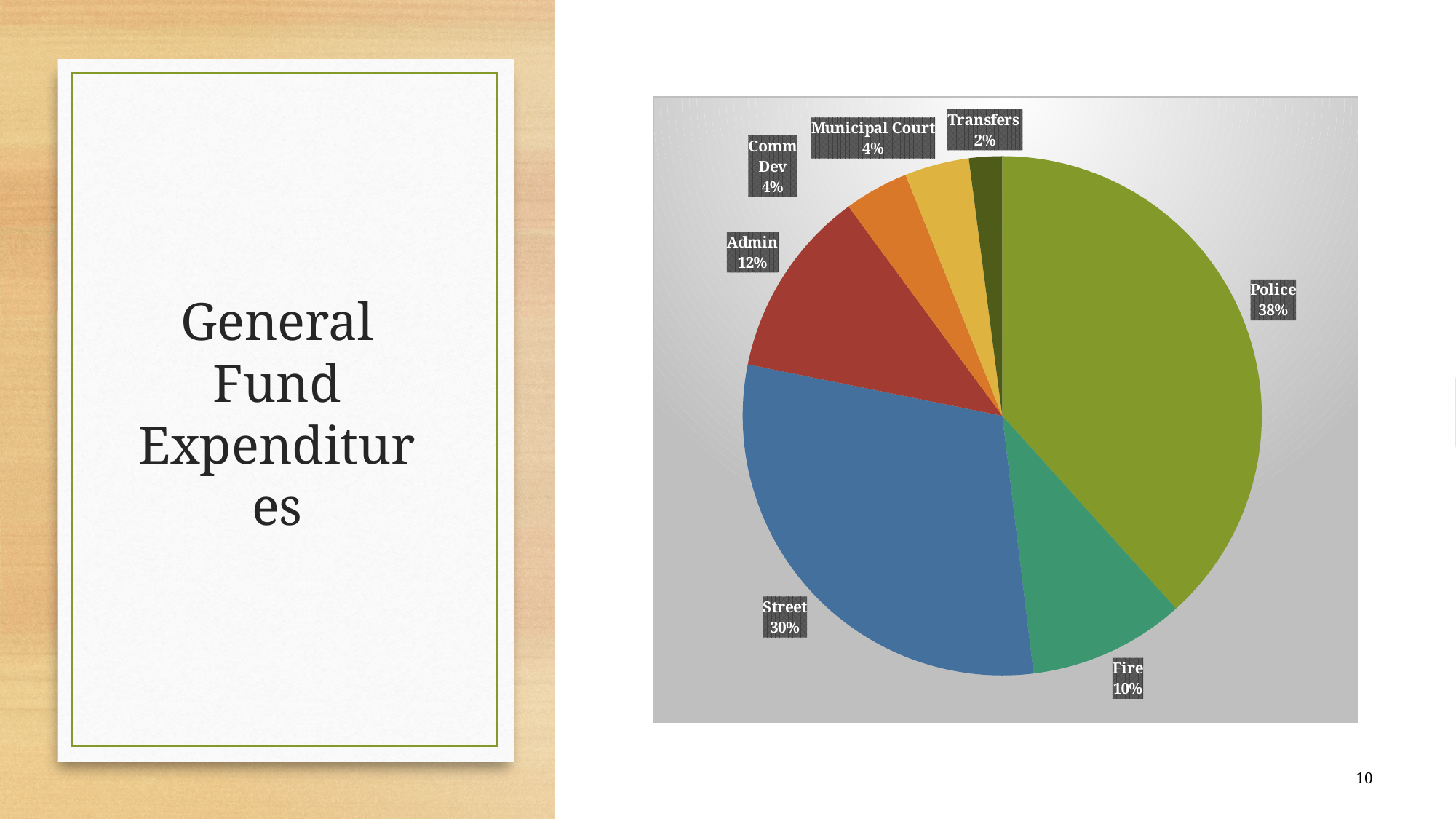
Which category has the smallest share of the pie? Transfers What share of General Fund Expenditures goes to Street? 30% What is the difference in percentage points between Police and Street? 8 What kind of chart is shown on the slide? pie chart What percentage is shown for Fire? 10% Which is larger, the share for Admin or the share for Fire? Admin What share of General Fund Expenditures goes to Police? 38% What percentage is shown for Admin? 12% Which category has the largest share of the pie? Police How many categories are shown in the pie chart? 7 What percentage is shown for Transfers? 2% What colour is the Street slice? blue